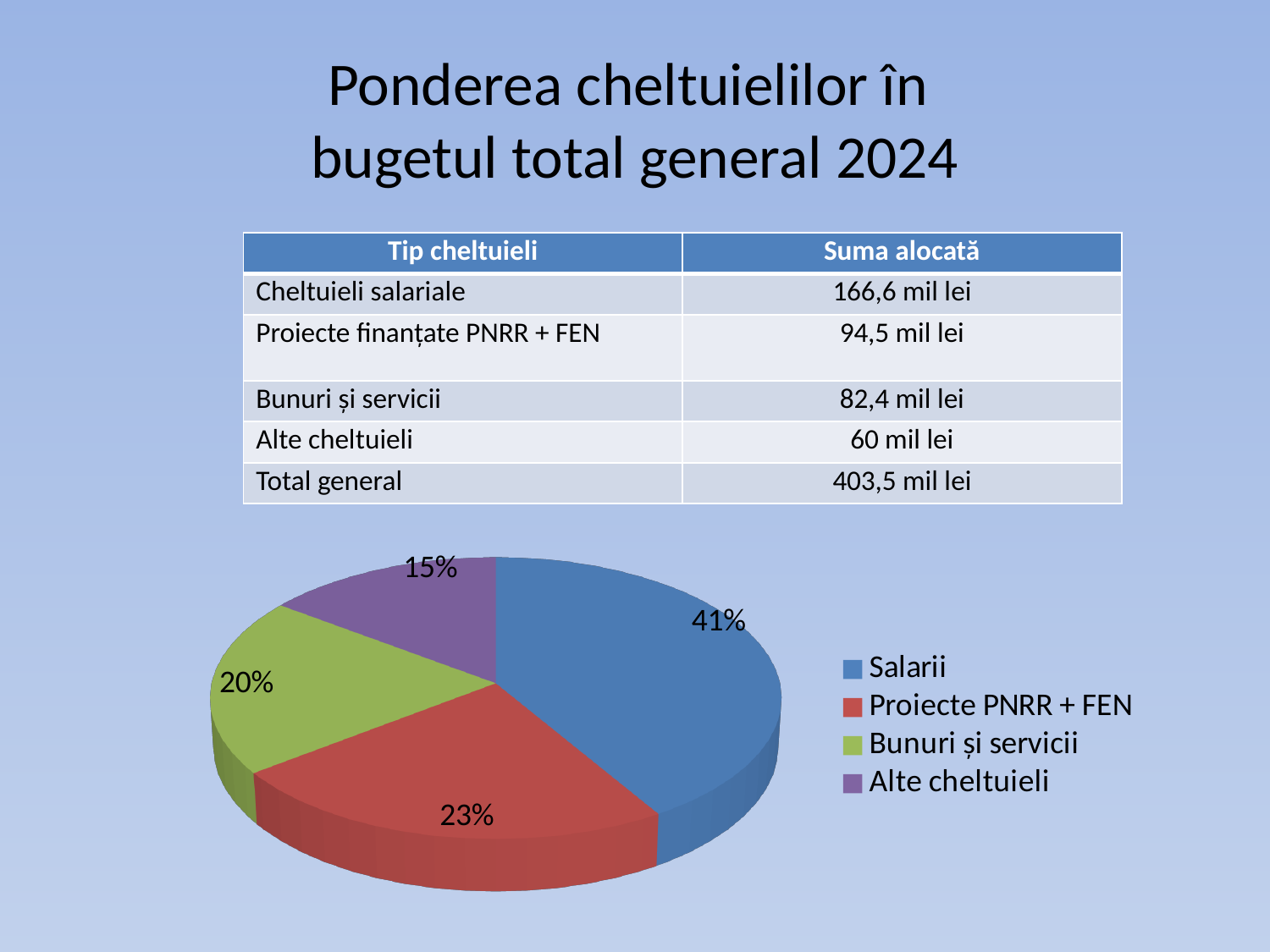
How many entries does the legend list? 4 What share of the pie does Alte cheltuieli have? 15% What share of the pie does Bunuri și servicii have? 20% What is the difference in percentage points between the Salarii slice and the Proiecte PNRR + FEN slice? 18 Which category has the smallest slice of the pie? Alte cheltuieli How many slices does the pie chart have? 4 Which category has the largest slice of the pie? Salarii What share of the pie does Salarii have? 41% What colour is the Proiecte PNRR + FEN slice? Red What kind of chart is shown on the slide? Pie chart Which slice is larger, Bunuri și servicii or Alte cheltuieli? Bunuri și servicii